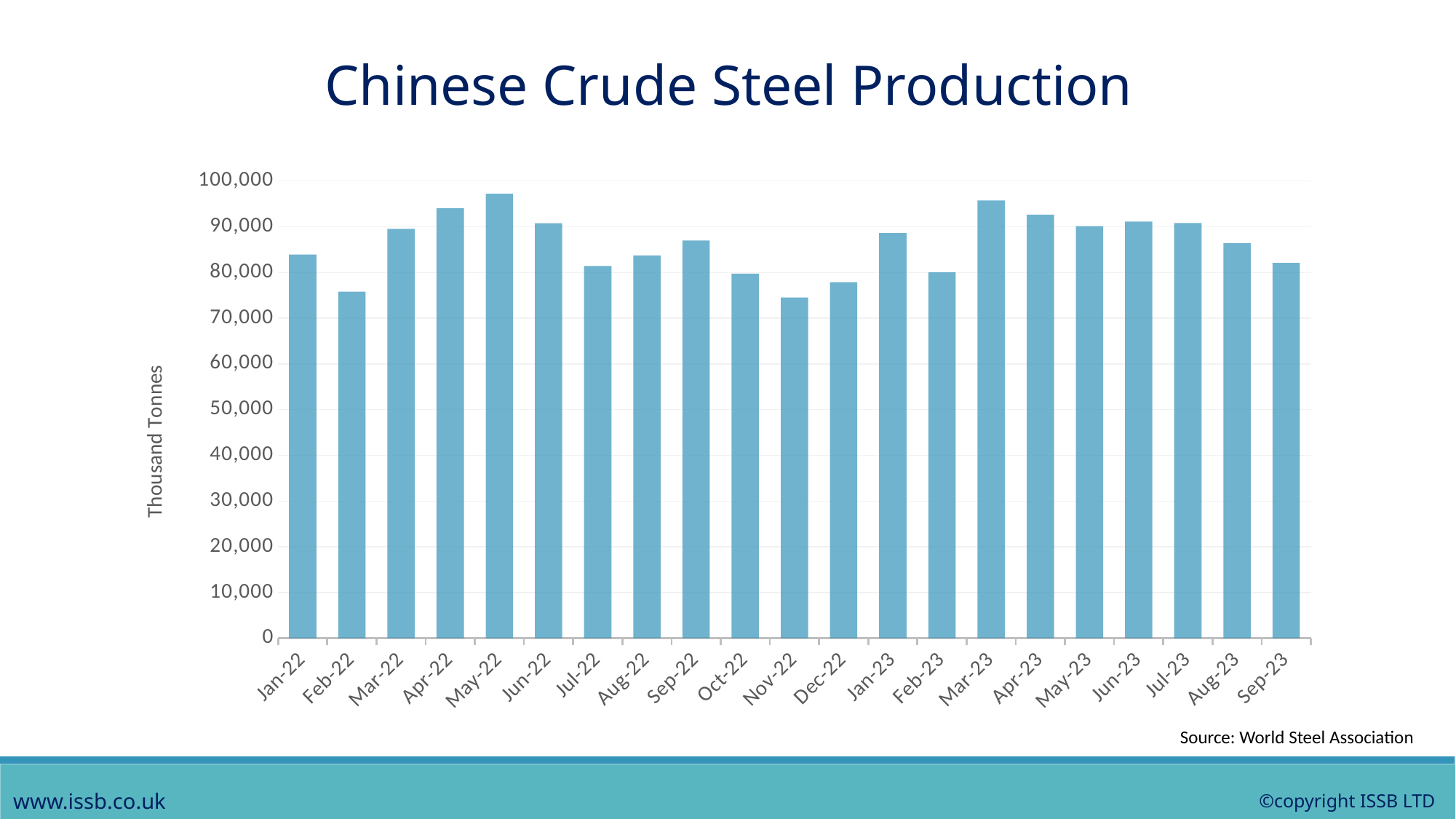
What unit is shown on the y axis label? Thousand Tonnes Which is larger, the value for Apr-22 or the value for Jul-22? Apr-22 Which is larger, the value for Mar-23 or the value for Sep-23? Mar-23 Is the value for Sep-23 greater or less than 90,000? less Which month has the highest crude steel production? May-22 Do the values rise or fall from Mar-22 to May-22? rise Is the value for Feb-22 greater or less than 80,000? less What type of chart is shown on the slide? Bar chart Is the value for Nov-22 greater or less than 80,000? less How many months are plotted on the x axis? 21